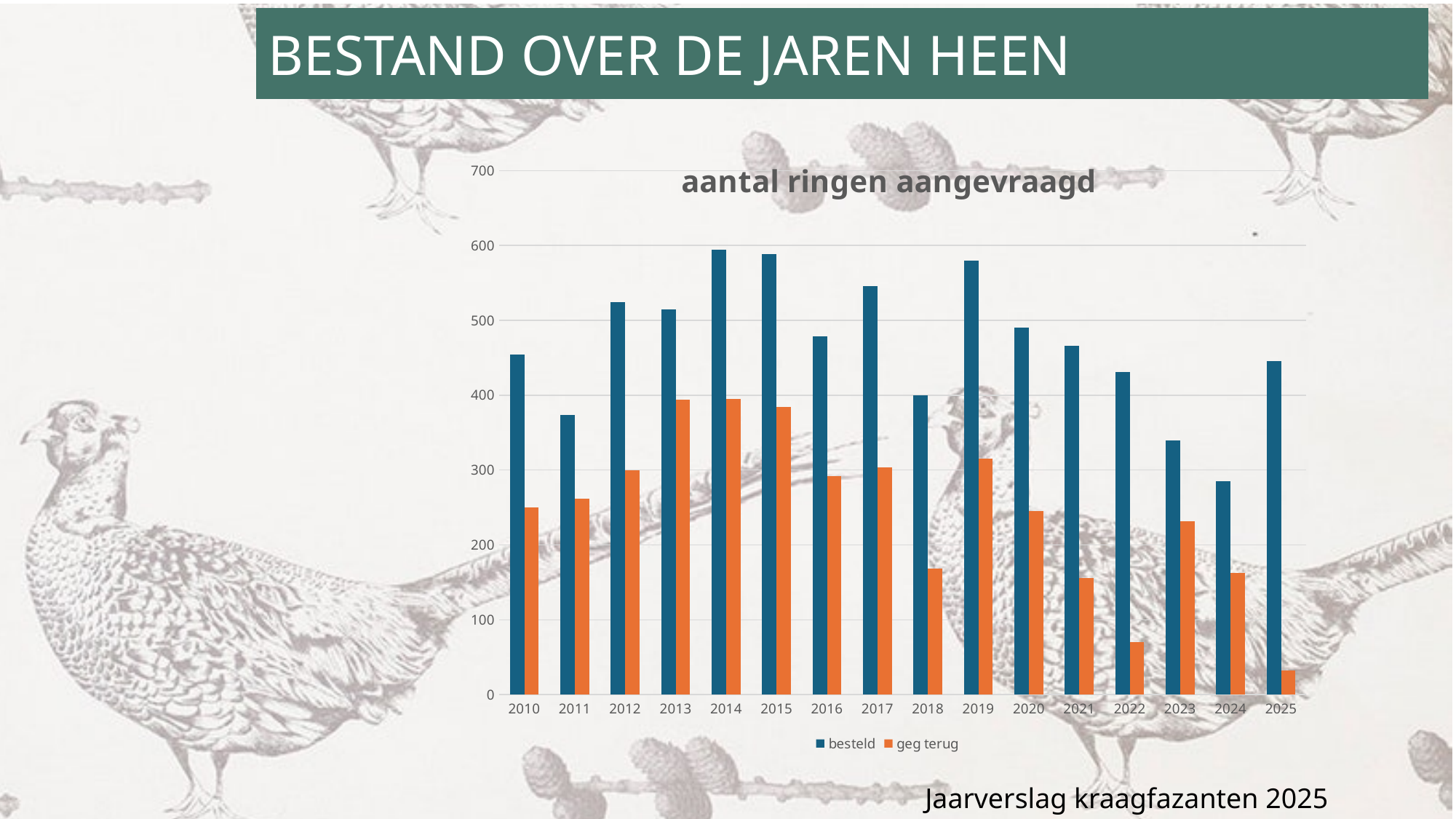
Which year has the lowest value for geg terug? 2025 What is the title of the chart? aantal ringen aangevraagd Is the value for besteld in 2011 greater or less than 400? less Which year has the lowest value for besteld? 2024 Is the value for besteld in 2012 greater or less than 500? greater Do the besteld values rise or fall from 2019 to 2024? fall What kind of chart is shown on the slide? bar chart How many series does the legend list? 2 How many years are shown on the x axis? 16 Is the value for geg terug in 2022 greater or less than 100? less Which is larger, geg terug in 2012 or geg terug in 2018? 2012 Which is larger, besteld in 2019 or besteld in 2020? 2019